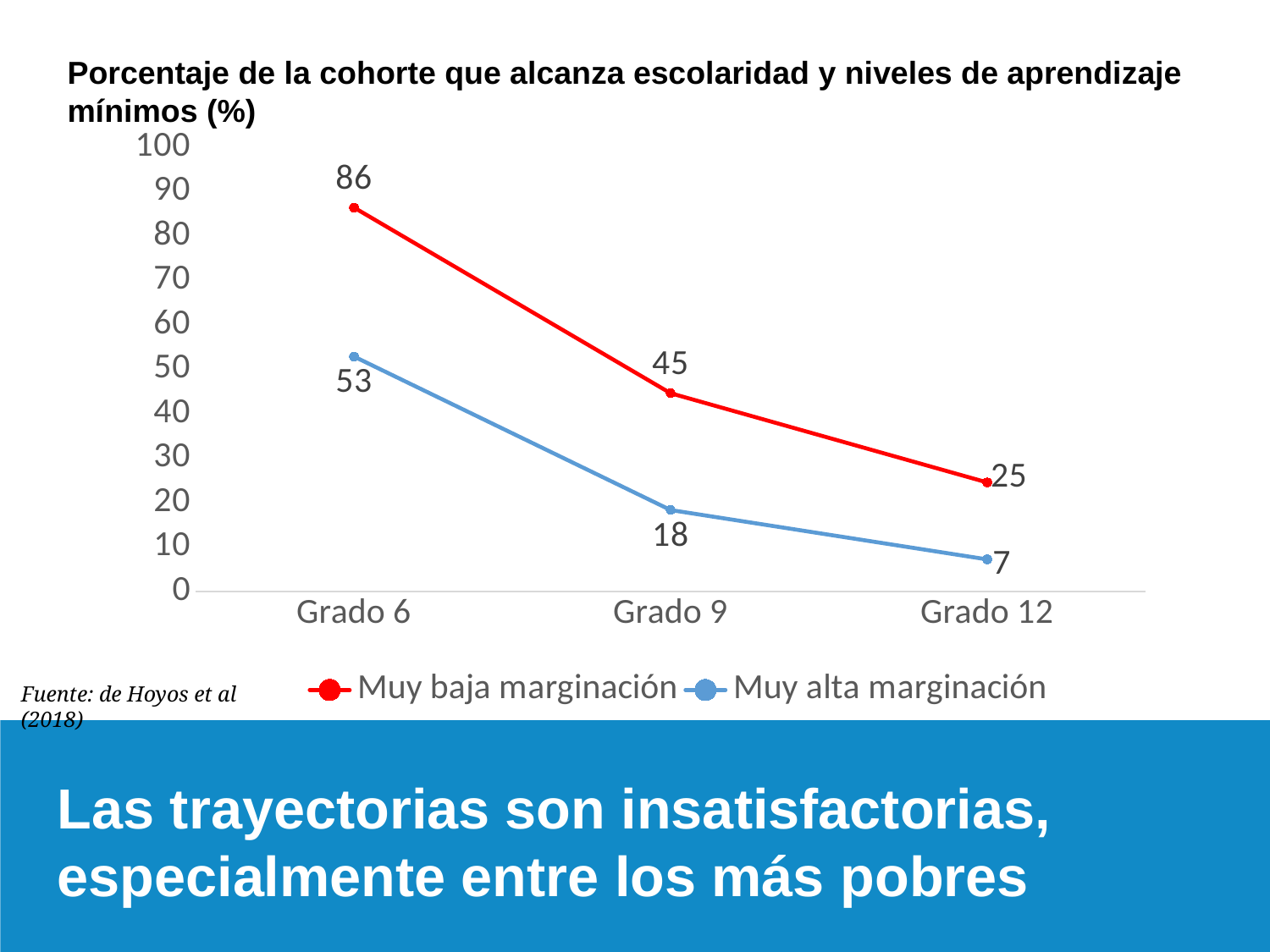
What is the value for Muy alta marginación at Grado 12? 7 What is the value for Muy alta marginación at Grado 9? 18 What is the value for Muy baja marginación at Grado 6? 86 What kind of chart is shown on the slide? Line chart Do the values for Muy baja marginación rise or fall from Grado 6 to Grado 12? Fall What is the value for Muy baja marginación at Grado 12? 25 At which grade is the value for Muy alta marginación highest? Grado 6 How many grade categories are shown on the x axis? 3 How many series does the legend list? 2 At which grade is the value for Muy baja marginación lowest? Grado 12 Which series has the larger value at Grado 9, Muy baja marginación or Muy alta marginación? Muy baja marginación What is the difference between Muy baja marginación and Muy alta marginación at Grado 6? 33